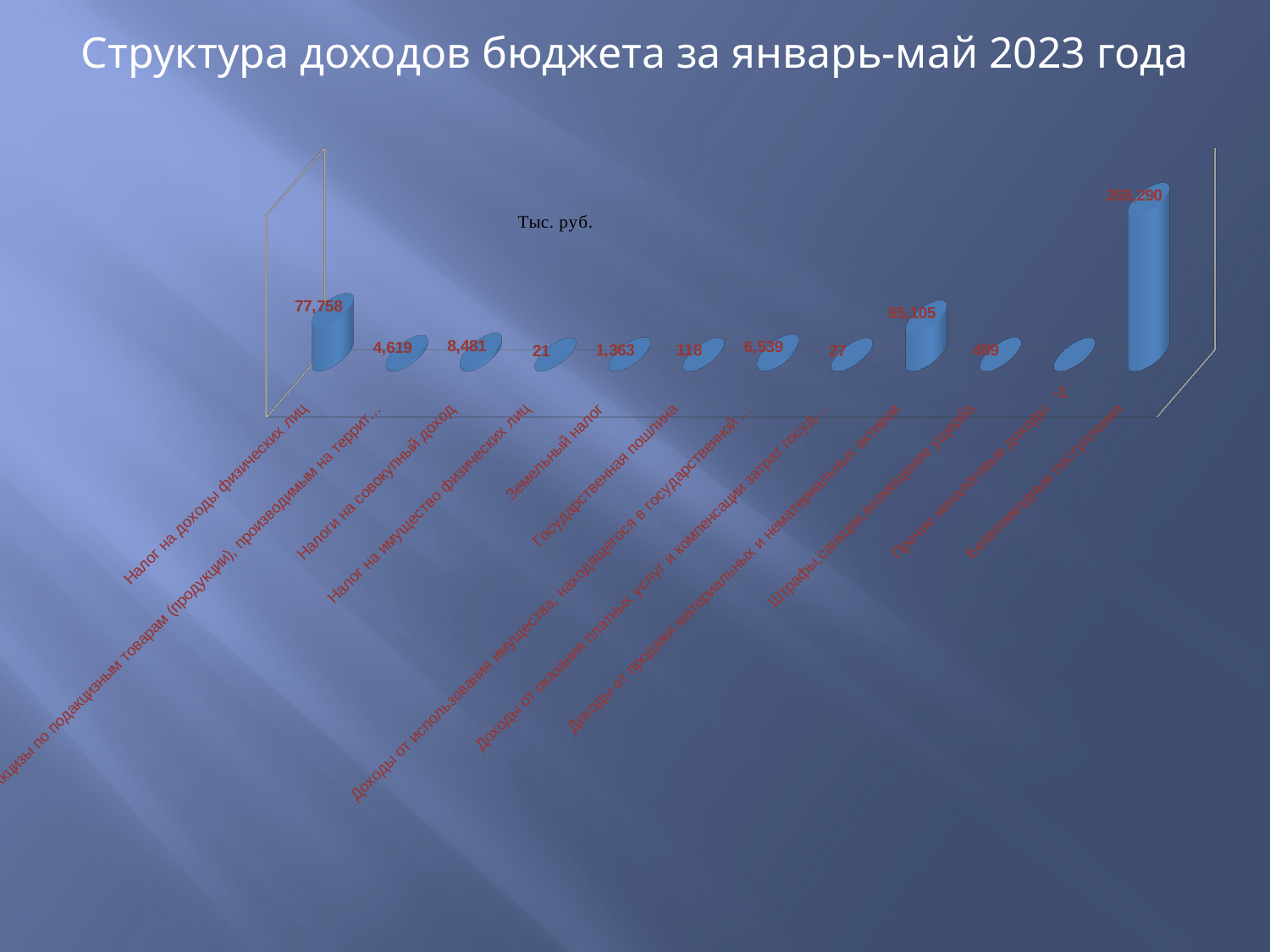
Which category has the highest value? Безвозмездные поступления How many categories are shown in the chart? 12 What is the value for Налоги на совокупный доход? 8,481 What kind of chart is shown on the slide? Bar chart What is the value for Земельный налог? 1,363 Which is larger: Налог на доходы физических лиц or Доходы от продажи материальных и нематериальных активов? Налог на доходы физических лиц What is the value for Доходы от продажи материальных и нематериальных активов? 65,105 What is the difference between Налог на доходы физических лиц and Доходы от продажи материальных и нематериальных активов? 12,653 What is the value for Налог на доходы физических лиц? 77,758 What is the value for Штрафы, санкции, возмещение ущерба? 499 Which category has the lowest value? Прочие неналоговые доходы What is the value for Государственная пошлина? 118